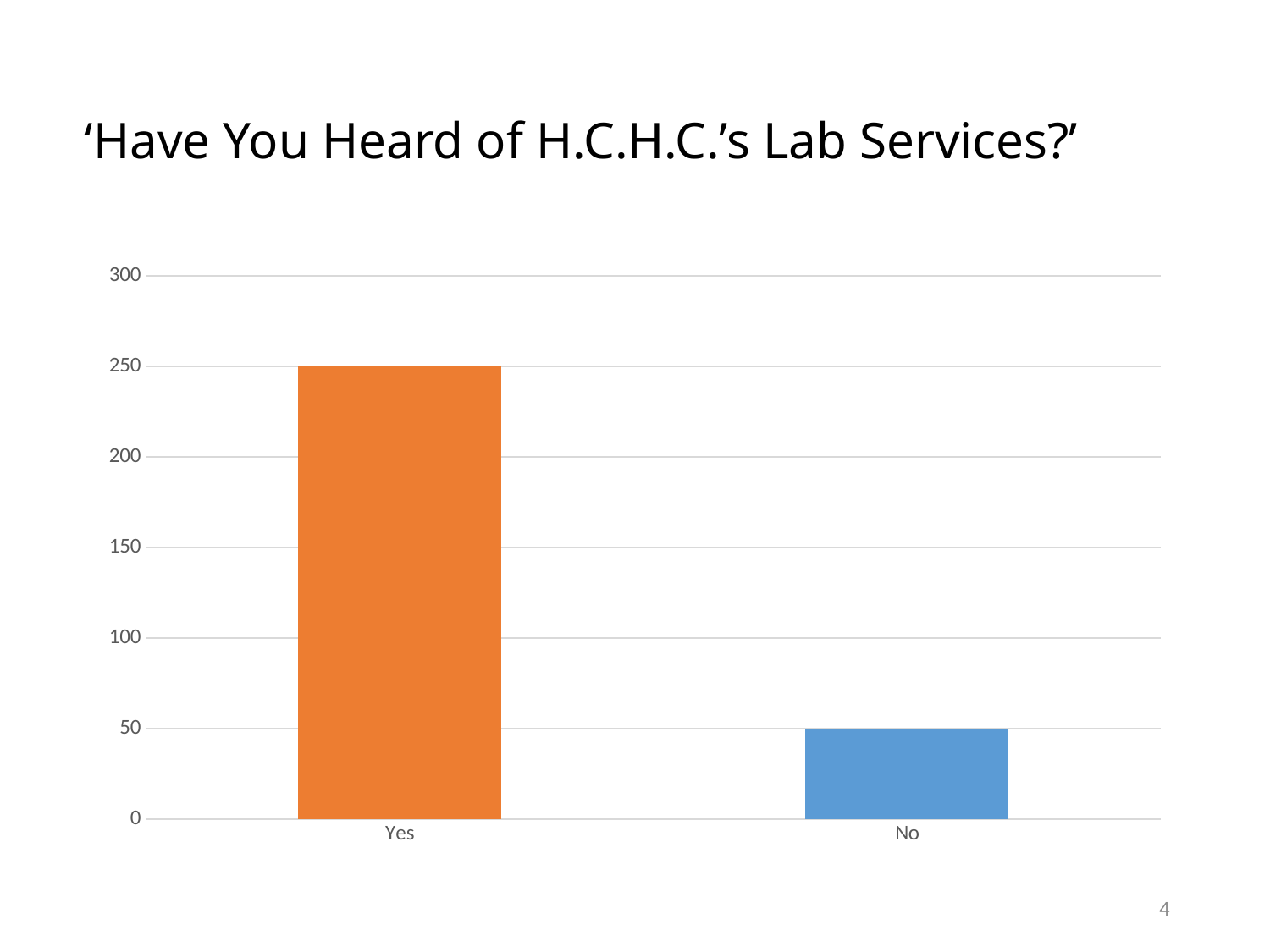
What colour is the bar for Yes? orange Which category has the highest value? Yes What is the value for Yes? 250 What kind of chart is shown on the slide? bar chart What is the title of the slide containing the chart? 'Have You Heard of H.C.H.C.'s Lab Services?' What is the difference between the values for Yes and No? 200 Which is larger, the value for Yes or the value for No? Yes What is the value for No? 50 How many categories are plotted in the chart? 2 Is the value for No greater or less than 100? less Which category has the lowest value? No Is the value for Yes greater or less than 200? greater